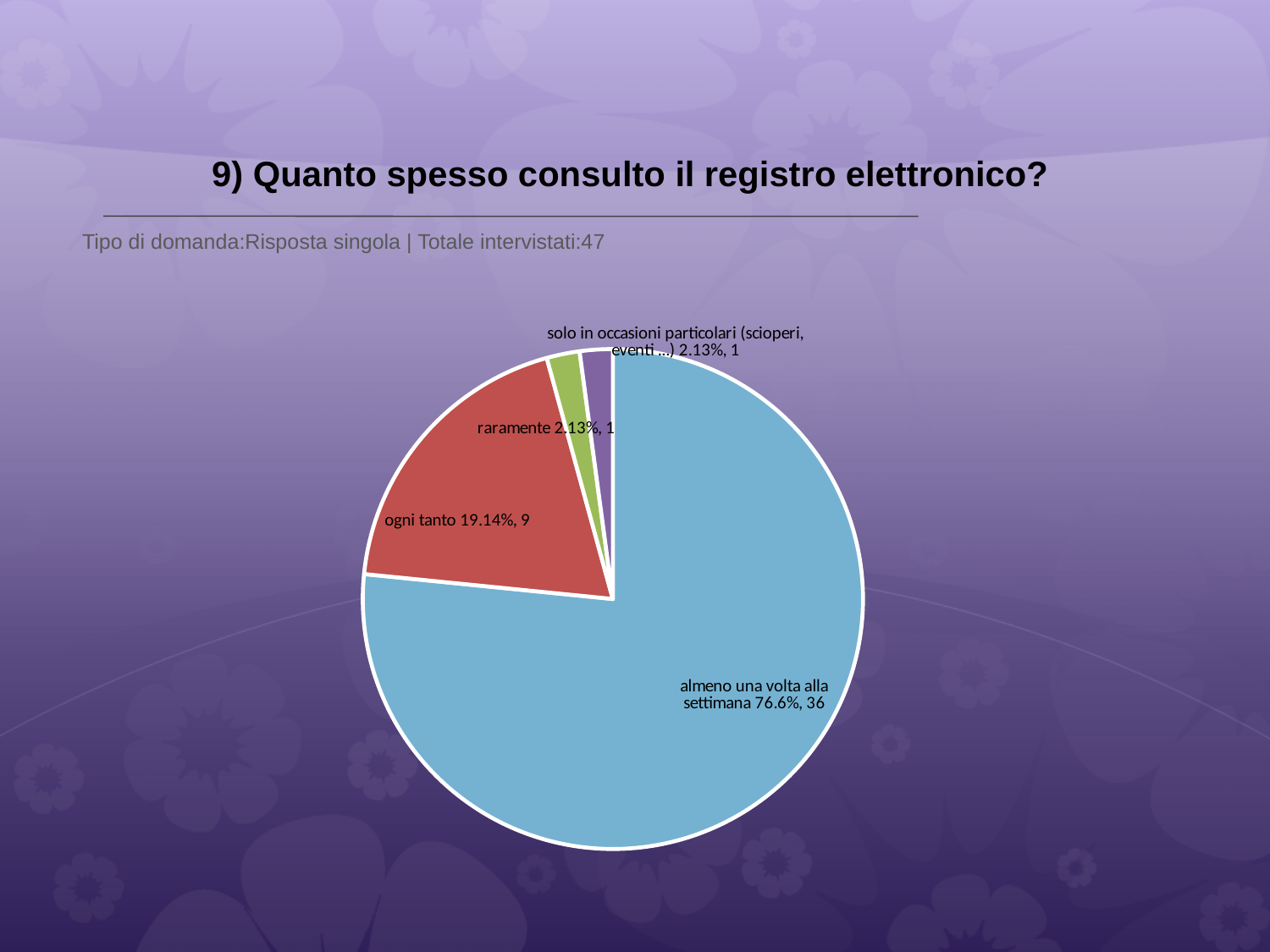
What is the total number of respondents across all slices of the pie? 47 How many respondents answered "raramente"? 1 What is the title of the chart on the slide? 9) Quanto spesso consulto il registro elettronico? How many slices does the pie chart have? 4 What percentage is shown for "ogni tanto"? 19.14% What kind of chart is shown on the slide? pie chart How many respondents answered "ogni tanto"? 9 Which is larger, the slice for "ogni tanto" or the slice for "raramente"? ogni tanto What is the difference in number of respondents between "almeno una volta alla settimana" and "ogni tanto"? 27 What percentage of respondents answered "almeno una volta alla settimana"? 76.6% What percentage is shown for "solo in occasioni particolari (scioperi, eventi ...)"? 2.13% Which answer has the largest slice of the pie? almeno una volta alla settimana